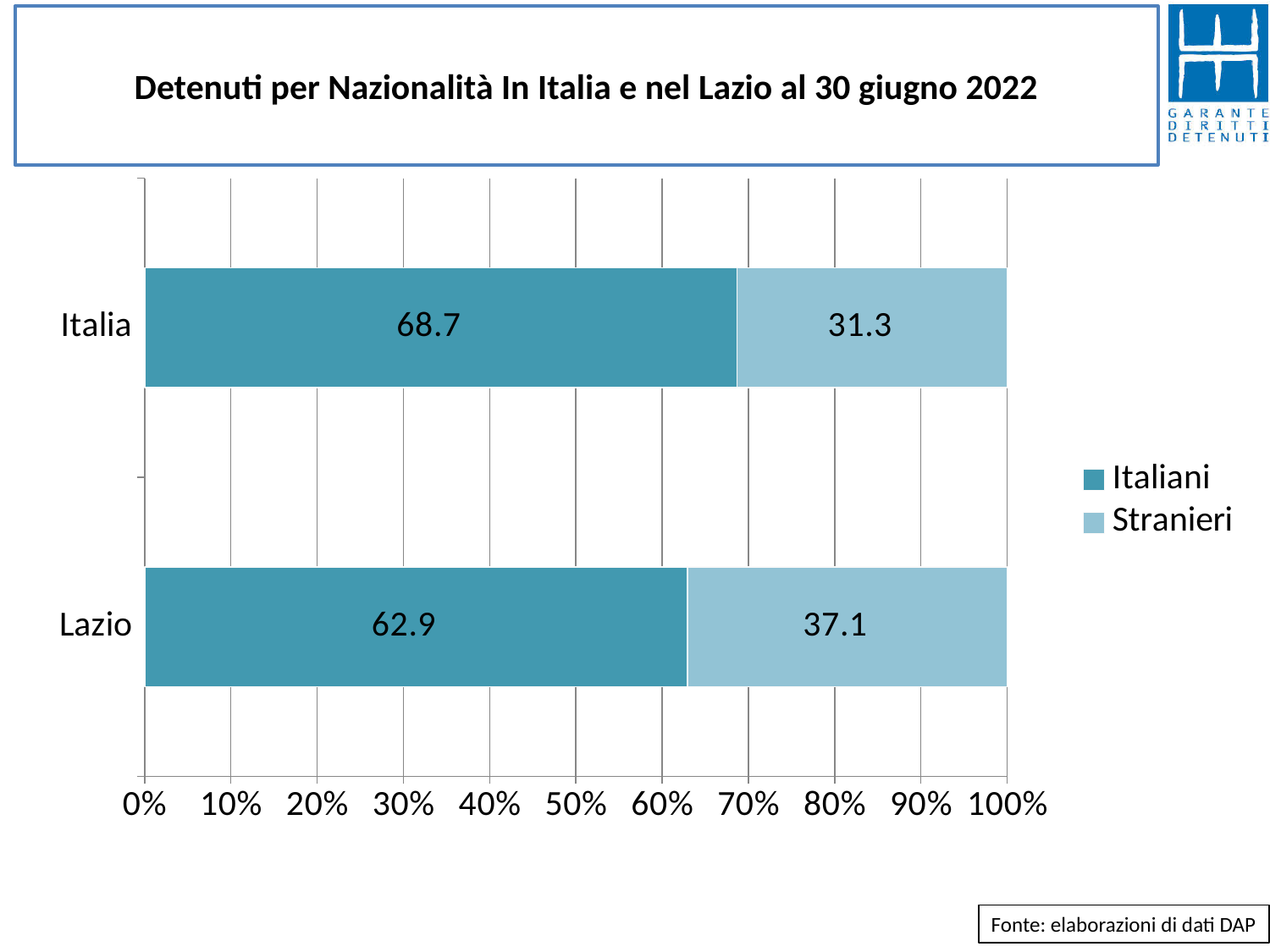
What is the value for Italiani in Italia? 68.7 What is the value for Stranieri in Lazio? 37.1 What is the difference between the Stranieri values for Lazio and Italia? 5.8 Which category has the lower value for Stranieri? Italia Which category has the higher value for Italiani, Italia or Lazio? Italia What kind of chart is shown on the slide? Stacked bar chart What is the value for Stranieri in Italia? 31.3 What is the difference between the Italiani values for Italia and Lazio? 5.8 How many categories are shown on the chart? 2 What is the title of the chart? Detenuti per Nazionalità In Italia e nel Lazio al 30 giugno 2022 What is the value for Italiani in Lazio? 62.9 How many series does the legend list? 2